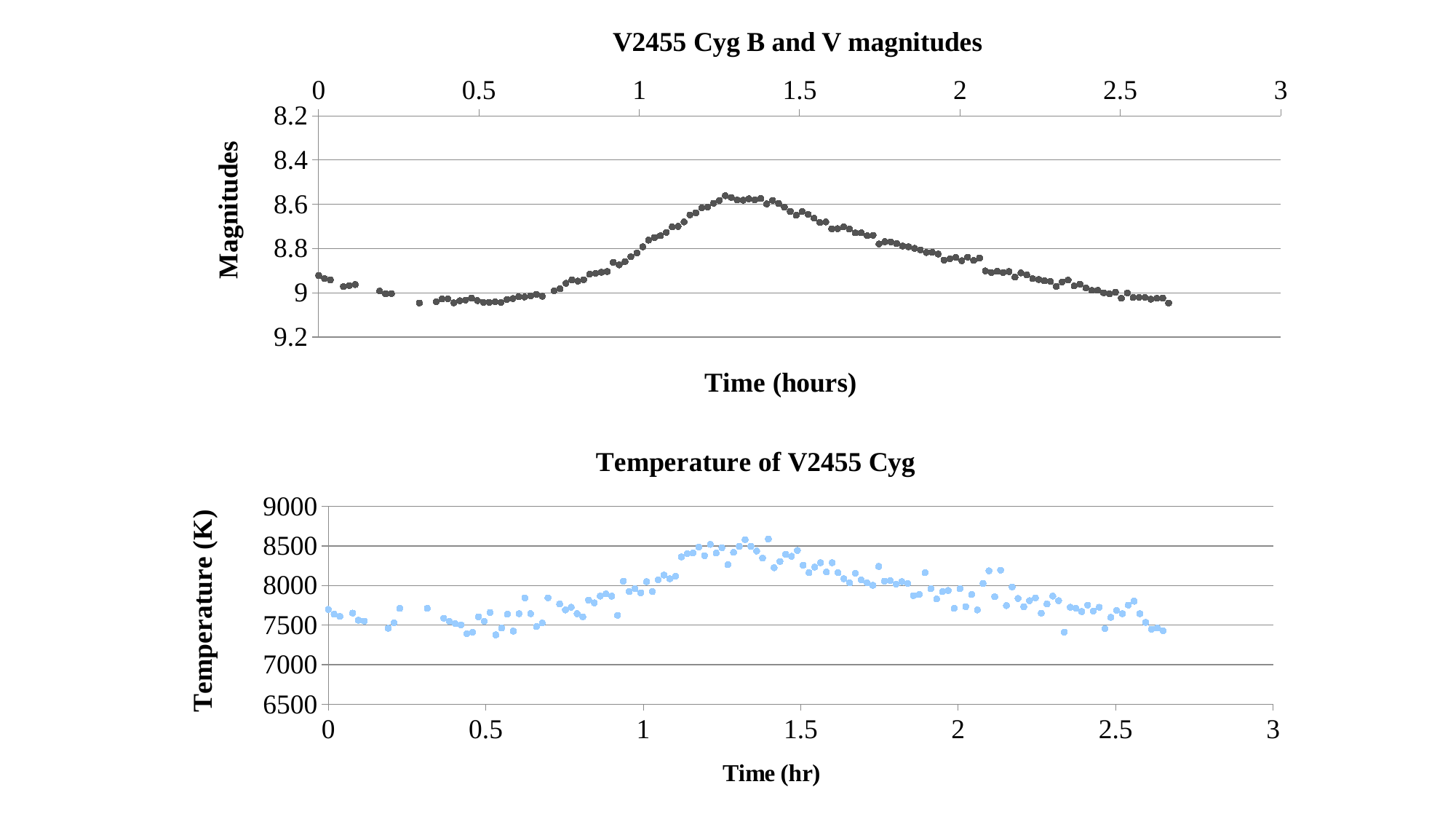
In the bottom chart, Temperature of V2455 Cyg, is the temperature at about 2.65 hours greater or less than 8000? less What is the title of the bottom chart? Temperature of V2455 Cyg In the bottom chart, Temperature of V2455 Cyg, does the temperature rise or fall between 0.7 and 1.3 hours? rise What is the title of the top chart? V2455 Cyg B and V magnitudes What kind of chart is the top chart, V2455 Cyg B and V magnitudes? Scatter chart In the bottom chart, Temperature of V2455 Cyg, is the temperature at about 1.3 hours greater or less than 8000? greater In the bottom chart, Temperature of V2455 Cyg, is the highest temperature plotted greater or less than 8000? greater In the bottom chart, Temperature of V2455 Cyg, does the temperature rise or fall between 1.5 and 2.5 hours? fall What kind of chart is the bottom chart, Temperature of V2455 Cyg? Scatter chart